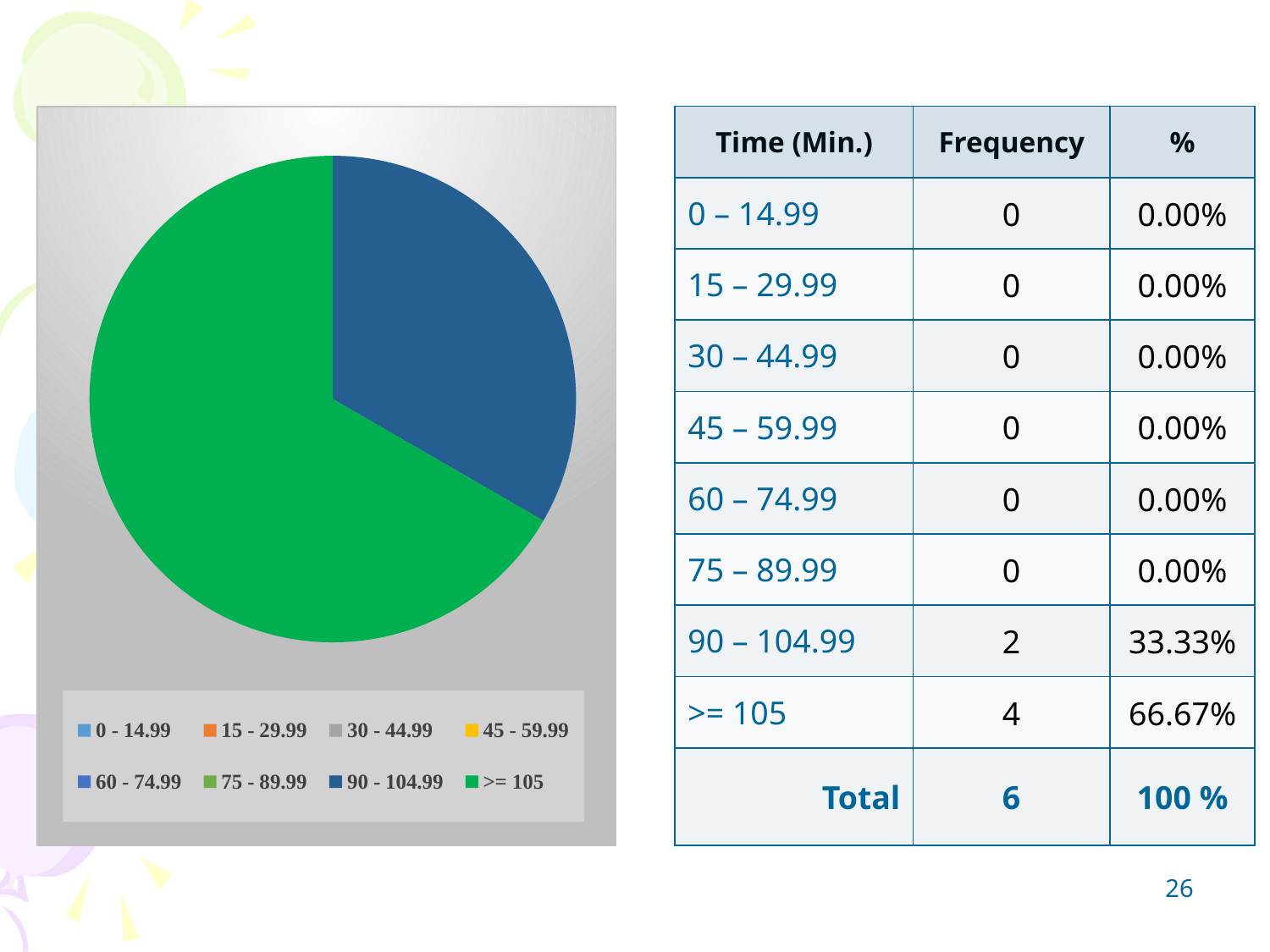
What is the frequency for the '90 - 104.99' category shown in the table? 2 How many slices are visible in the pie chart? 2 What share of the pie does the '>= 105' slice represent, according to the table? 66.67% What colour is the '>= 105' slice in the pie chart? green Which category has the largest slice in the pie chart? >= 105 What kind of chart is shown on the left of the slide? pie chart How many categories does the pie chart's legend list? 8 What is the total frequency across all categories shown in the table? 6 In the pie chart, which slice is larger: '>= 105' or '90 - 104.99'? >= 105 What share of the pie does the '90 - 104.99' slice represent, according to the table? 33.33% Of the two visible slices in the pie chart, which is smaller? 90 - 104.99 What is the frequency for the '>= 105' category shown in the table? 4